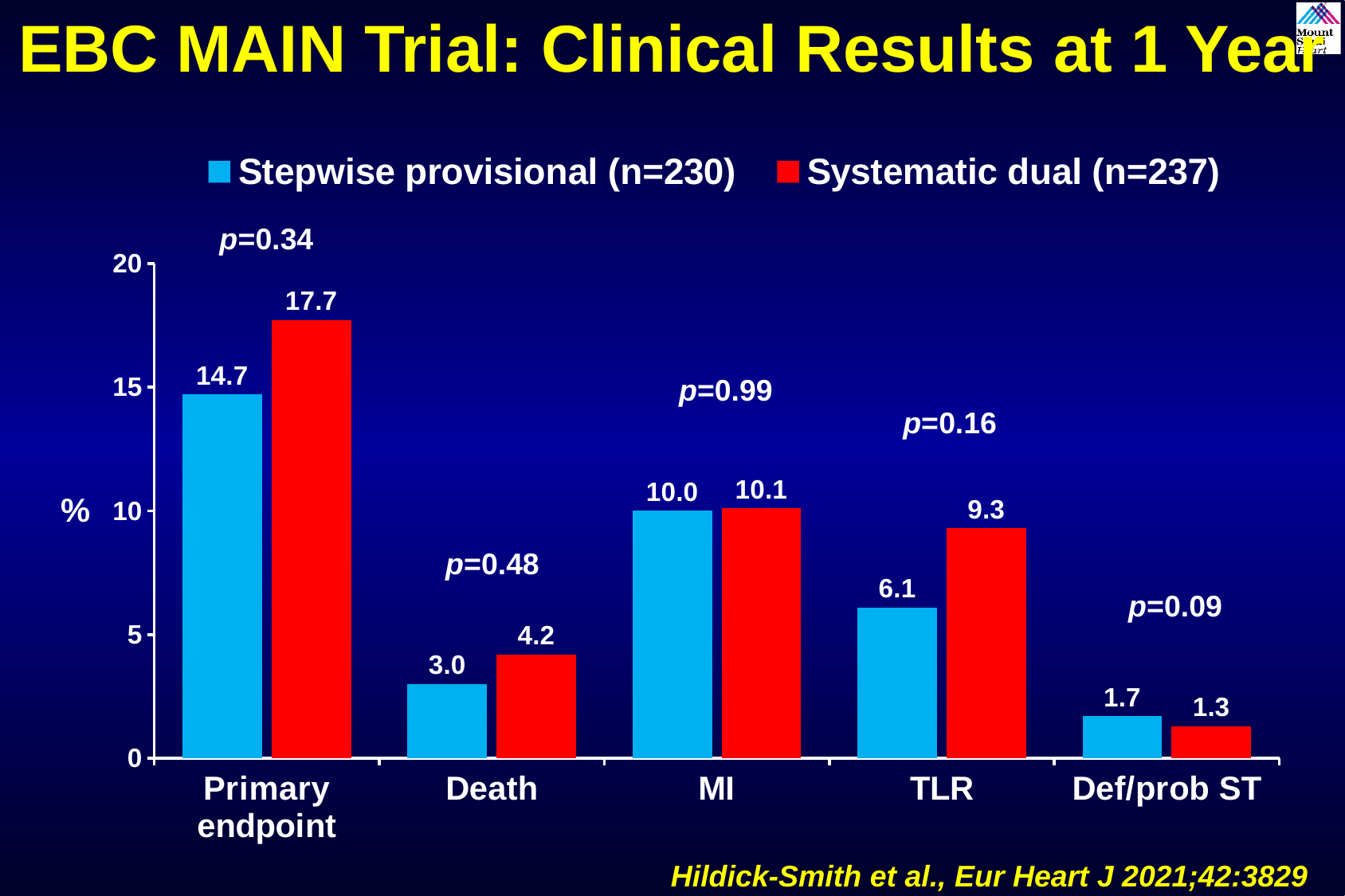
What is the value for Stepwise provisional (n=230) for the Primary endpoint? 14.7 Which category has the lowest value for Stepwise provisional (n=230)? Def/prob ST What p-value is shown above the MI bars? p=0.99 What colour are the bars for Systematic dual (n=237)? Red What is the difference between the Systematic dual (n=237) and Stepwise provisional (n=230) values for the Primary endpoint? 3.0 How many categories are shown on the x axis? 5 What is the value for Systematic dual (n=237) for Death? 4.2 For TLR, which series has the larger value, Stepwise provisional (n=230) or Systematic dual (n=237)? Systematic dual (n=237) What kind of chart is shown on the slide? Bar chart Which category has the highest value for Systematic dual (n=237)? Primary endpoint How many series does the legend list? 2 What is the value for Systematic dual (n=237) for TLR? 9.3